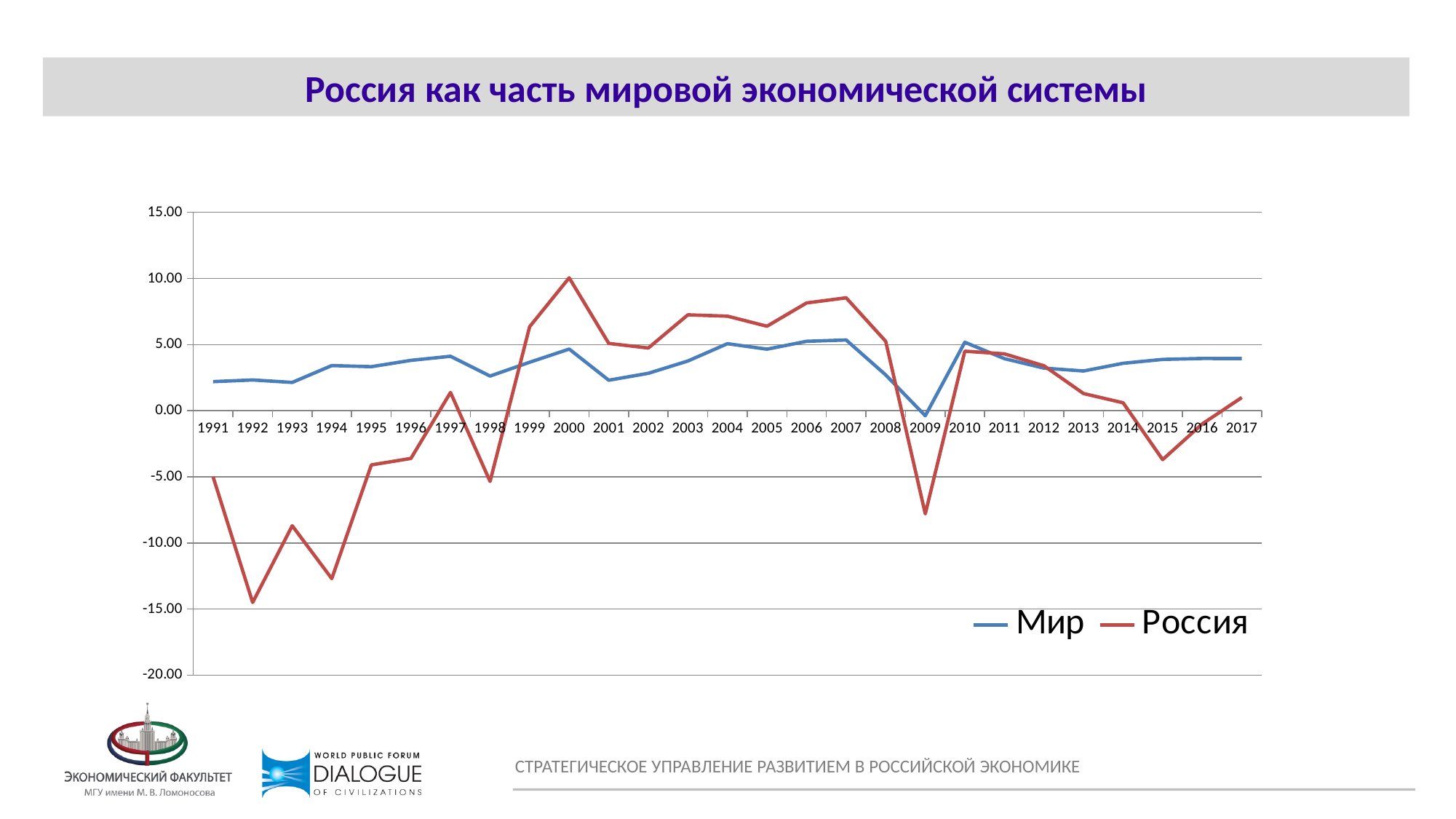
How many series does the legend list? 2 In which year does the Россия series reach its lowest value? 1992 In which year does the Мир series reach its lowest value? 2009 What are the two series named in the legend? Мир and Россия Is the value for Россия in 2015 greater or less than 0.00? less Is the value for Россия in 2000 greater or less than 5.00? greater In 2000, which series has the larger value, Мир or Россия? Россия How many years are plotted along the x axis? 27 In which year does the Россия series reach its highest value? 2000 What kind of chart is shown on the slide? line chart In 2009, which series has the larger value, Мир or Россия? Мир Is the value for Россия in 1992 greater or less than -10.00? less